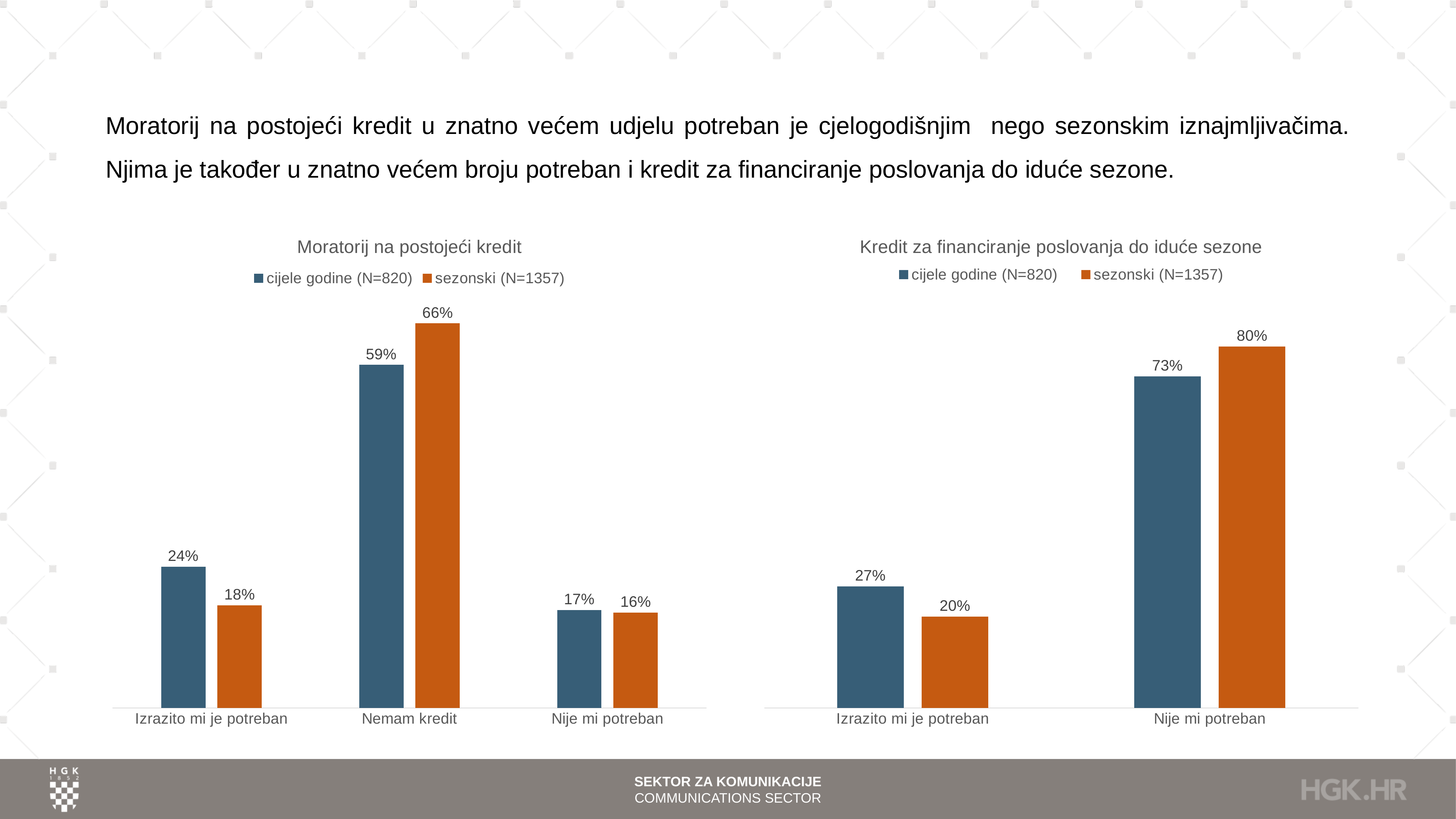
In the 'Moratorij na postojeći kredit' chart, which category has the highest value for 'sezonski (N=1357)'? Nemam kredit In the 'Moratorij na postojeći kredit' chart, what is the value for 'sezonski (N=1357)' in the 'Izrazito mi je potreban' category? 18% In the 'Moratorij na postojeći kredit' chart, what is the difference between 'cijele godine (N=820)' and 'sezonski (N=1357)' in the 'Izrazito mi je potreban' category? 6% In the 'Kredit za financiranje poslovanja do iduće sezone' chart, what is the value for 'cijele godine (N=820)' in the 'Izrazito mi je potreban' category? 27% What type of chart is the 'Kredit za financiranje poslovanja do iduće sezone' chart? Bar chart How many categories are shown on the x axis of the 'Moratorij na postojeći kredit' chart? 3 In the 'Moratorij na postojeći kredit' chart, which category has the lowest value for 'cijele godine (N=820)'? Nije mi potreban In the 'Kredit za financiranje poslovanja do iduće sezone' chart, what is the value for 'sezonski (N=1357)' in the 'Nije mi potreban' category? 80% How many series does the legend of the 'Kredit za financiranje poslovanja do iduće sezone' chart list? 2 In the 'Kredit za financiranje poslovanja do iduće sezone' chart, which series has the larger value in the 'Izrazito mi je potreban' category? cijele godine (N=820) In the 'Kredit za financiranje poslovanja do iduće sezone' chart, what is the difference between 'sezonski (N=1357)' and 'cijele godine (N=820)' in the 'Nije mi potreban' category? 7% In the 'Moratorij na postojeći kredit' chart, what is the value for 'cijele godine (N=820)' in the 'Nemam kredit' category? 59%